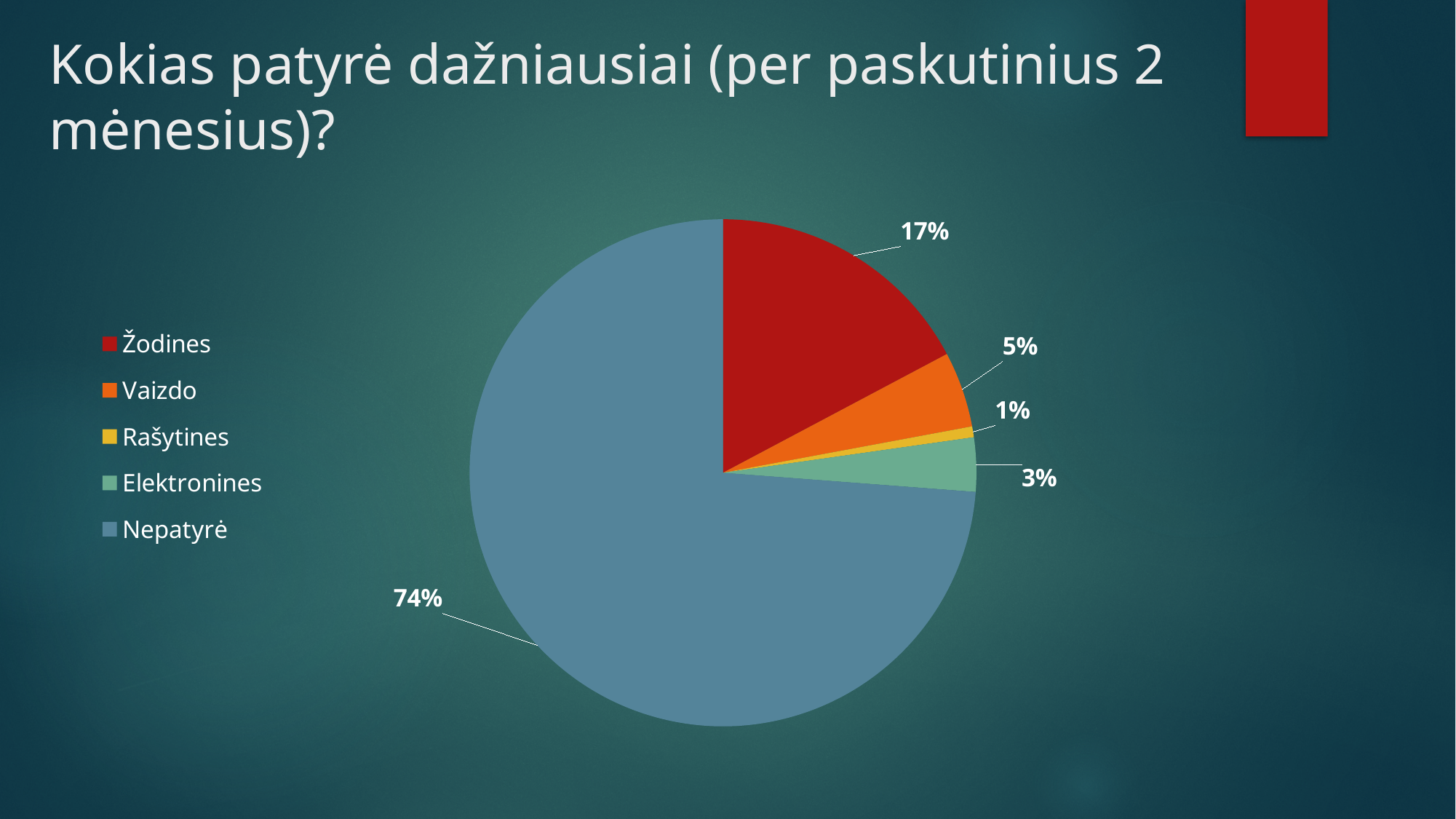
What is the difference between the values for Žodines and Vaizdo? 12% What is the value for Vaizdo? 5% Which category has the smallest slice? Rašytines Which category has the largest slice? Nepatyrė What colour is the Žodines slice? red What kind of chart is shown on the slide? pie chart What is the value for Rašytines? 1% What share of the pie does Žodines have? 17% What is the value for Elektronines? 3% Which is larger, Elektronines or Vaizdo? Vaizdo What share of the pie does Nepatyrė have? 74% How many categories does the legend list? 5